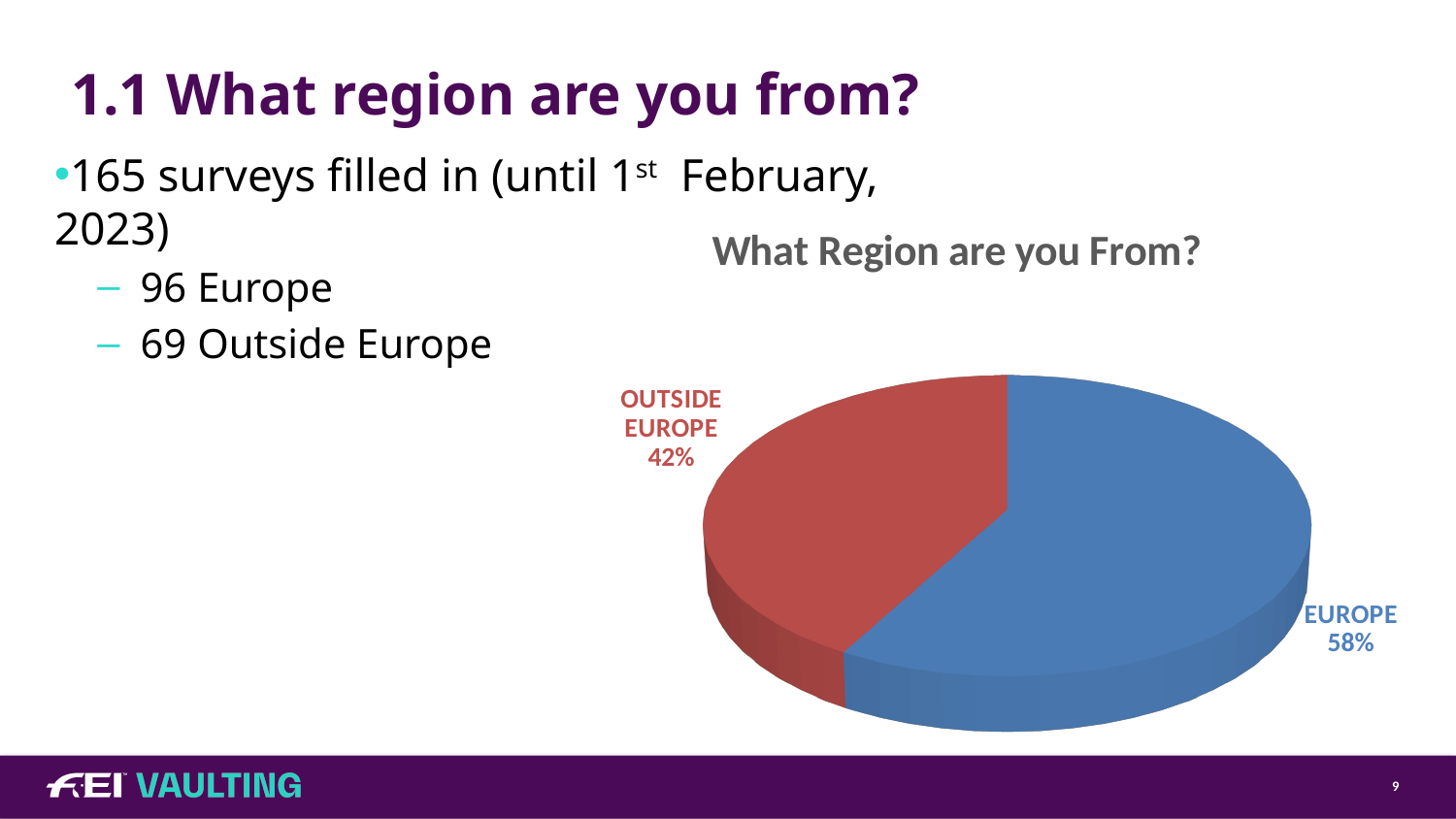
Which slice of the pie is the smallest? OUTSIDE EUROPE Which slice of the pie is the largest? EUROPE What colour is the EUROPE slice? Blue What is the difference in percentage points between the EUROPE and OUTSIDE EUROPE slices? 16 Which slice is larger, EUROPE or OUTSIDE EUROPE? EUROPE What share of the pie does EUROPE represent? 58% What is the title of the chart? What Region are you From? What share of the pie does OUTSIDE EUROPE represent? 42% How many slices does the pie chart have? 2 What kind of chart is shown on the slide? Pie chart